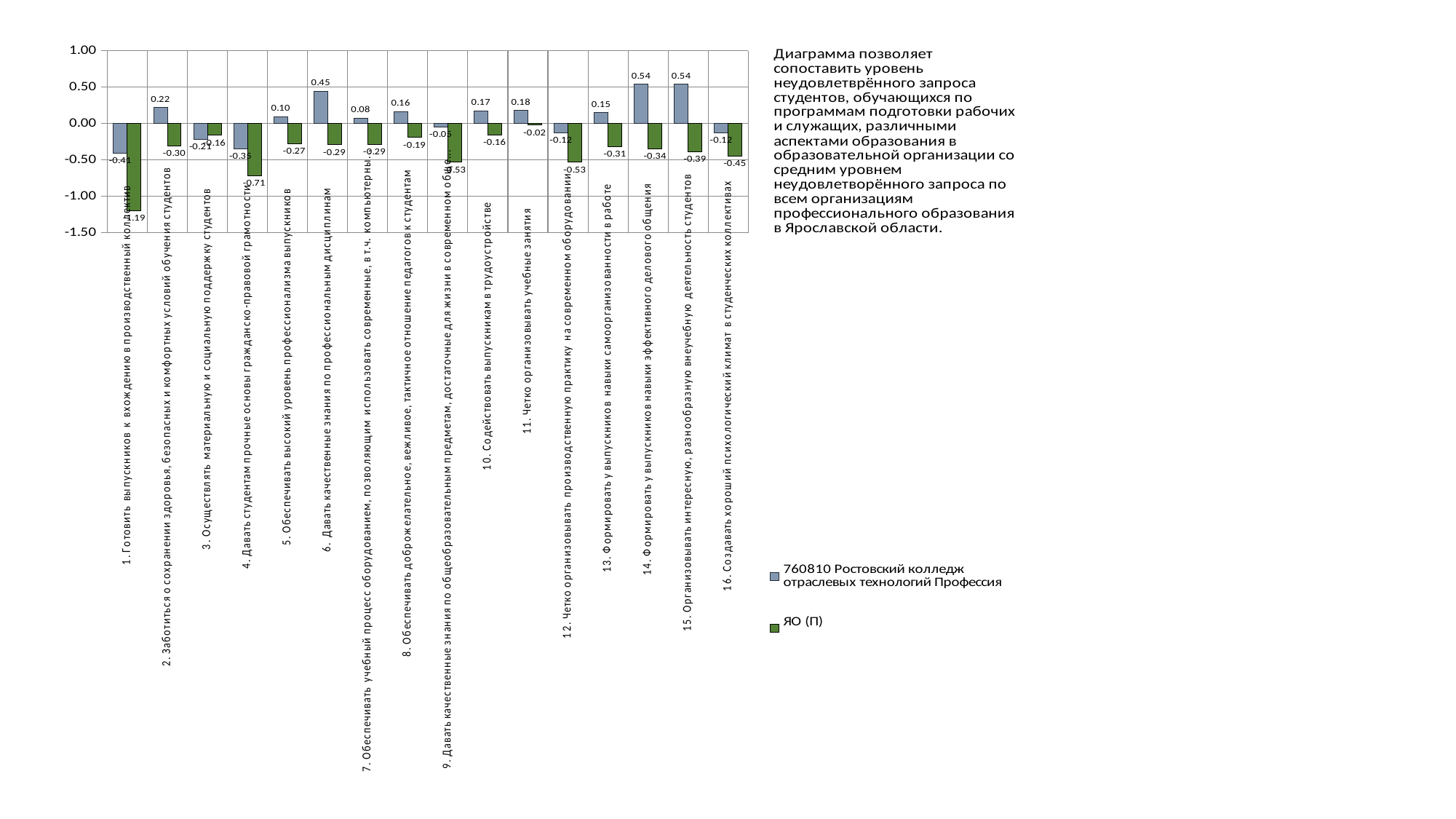
What kind of chart is shown on the slide? bar chart What is the highest value shown for the series "760810 Ростовский колледж отраслевых технологий Профессия"? 0.54 What is the difference between the two series' values in category 14 (Формировать у выпускников навыки эффективного делового общения)? 0.88 In category 16 (Создавать хороший психологический климат в студенческих коллективах), which series has the larger value? 760810 Ростовский колледж отраслевых технологий Профессия Which category has the lowest value for the series "ЯО (П)"? 1. Готовить выпускников к вхождению в производственный коллектив How many categories are plotted along the x axis? 16 What is the value for the series "ЯО (П)" in category 4 (Давать студентам прочные основы гражданско-правовой грамотности)? -0.71 What is the value for the series "760810 Ростовский колледж отраслевых технологий Профессия" in category 2 (Заботиться о сохранении здоровья, безопасных и комфортных условий обучения студентов)? 0.22 What is the value for the series "ЯО (П)" in category 11 (Четко организовывать учебные занятия)? -0.02 What colour are the bars for the series "ЯО (П)"? green What is the value for the series "760810 Ростовский колледж отраслевых технологий Профессия" in category 6 (Давать качественные знания по профессиональным дисциплинам)? 0.45 How many series does the legend list? 2